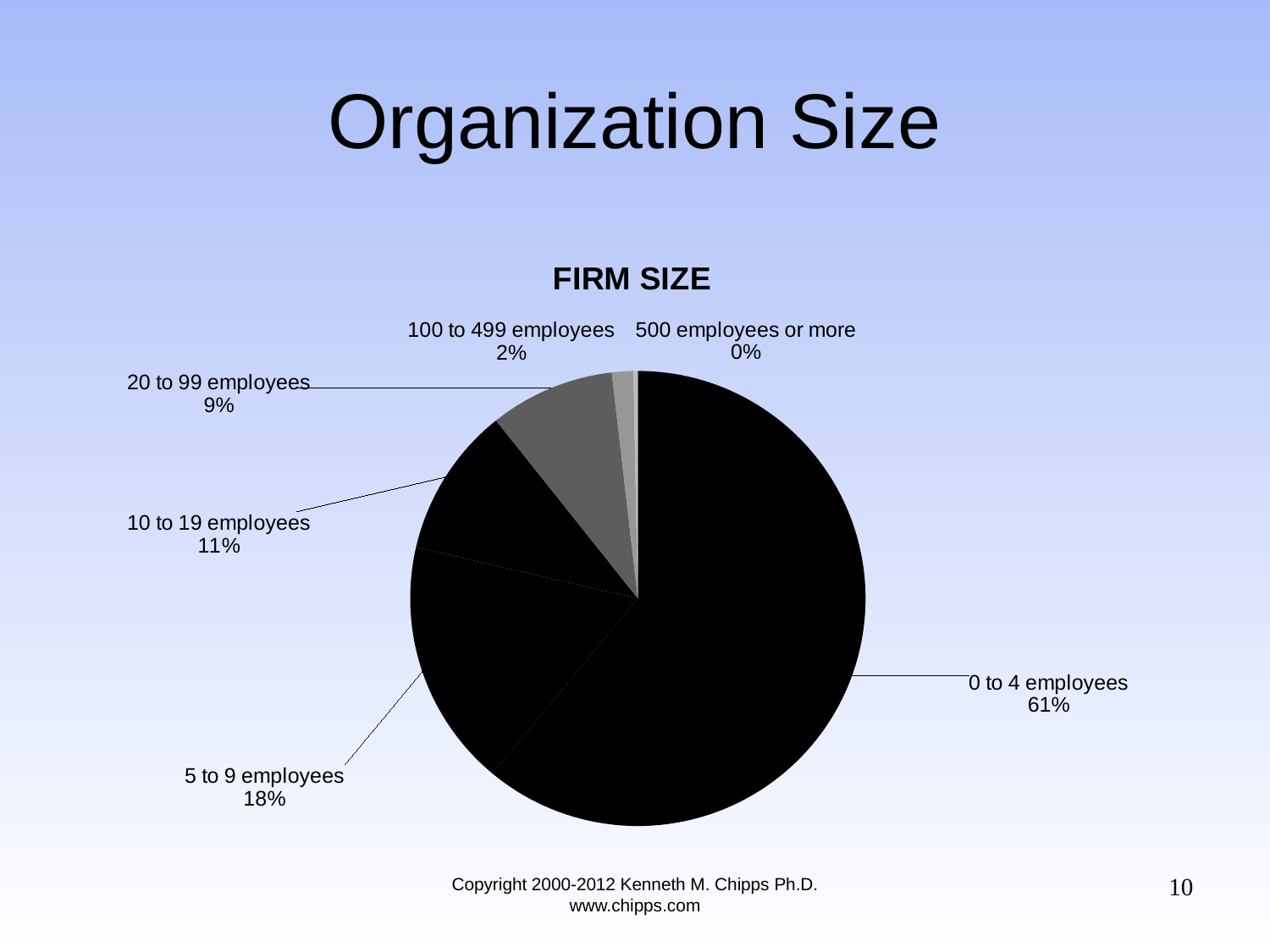
What is the title of the chart? FIRM SIZE What is the difference in share between 0 to 4 employees and 5 to 9 employees? 43% What share of the pie is for 10 to 19 employees? 11% How many firm size categories are shown in the pie chart? 6 Which firm size category has the largest share? 0 to 4 employees What share of the pie is for 100 to 499 employees? 2% What type of chart is shown on the slide? pie chart What share of the pie is for 20 to 99 employees? 9% Which firm size category has the smallest share? 500 employees or more